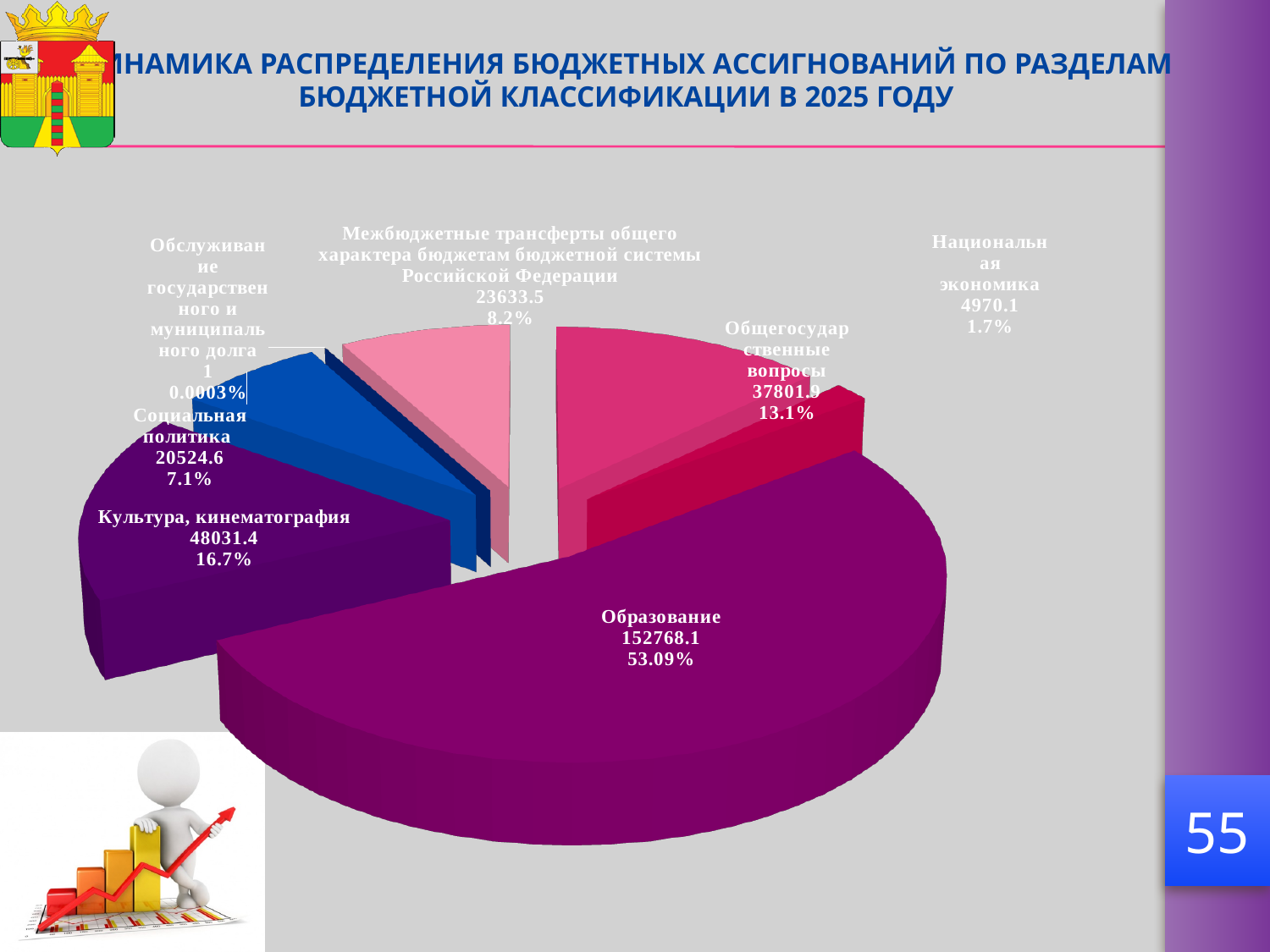
What is the value shown for Образование? 152768.1 Which is larger: Социальная политика or Межбюджетные трансферты общего характера бюджетам бюджетной системы Российской Федерации? Межбюджетные трансферты общего характера бюджетам бюджетной системы Российской Федерации Which section has the largest slice of the pie? Образование What is the value shown for Культура, кинематография? 48031.4 What is the difference between the values for Культура, кинематография and Социальная политика? 27506.8 Which section has the smallest slice of the pie? Обслуживание государственного и муниципального долга What share of the pie does Национальная экономика account for? 1.7% What is the value shown for Социальная политика? 20524.6 What kind of chart is shown on the slide? Pie chart What share of the pie does Культура, кинематография account for? 16.7% What share of the pie does Образование account for? 53.09% How many sections are shown in the pie chart? 7